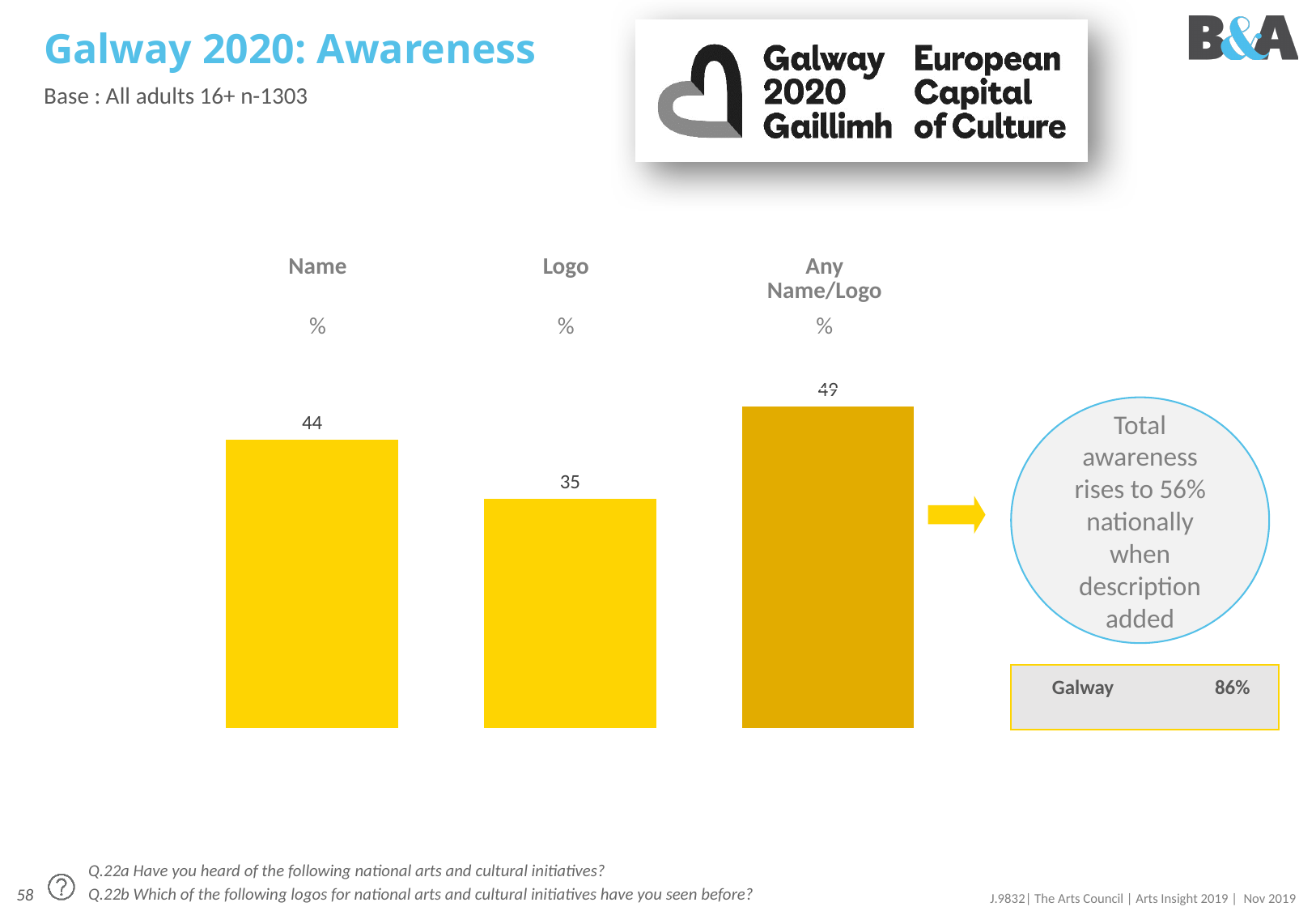
Which is larger, the value for Name or the value for Logo? Name What is the value for Logo? 35 How many bars are shown in the chart? 3 What is the difference between the values for Name and Logo? 9 What is the difference between the values for Any Name/Logo and Name? 5 Which category has the highest value? Any Name/Logo What kind of chart is shown on the slide? Bar chart What is the value for Name? 44 What awareness percentage is shown for Galway in the box at the right of the chart? 86% What is the value for Any Name/Logo? 49 What is the base described for the chart? All adults 16+ n-1303 Which category has the lowest value? Logo